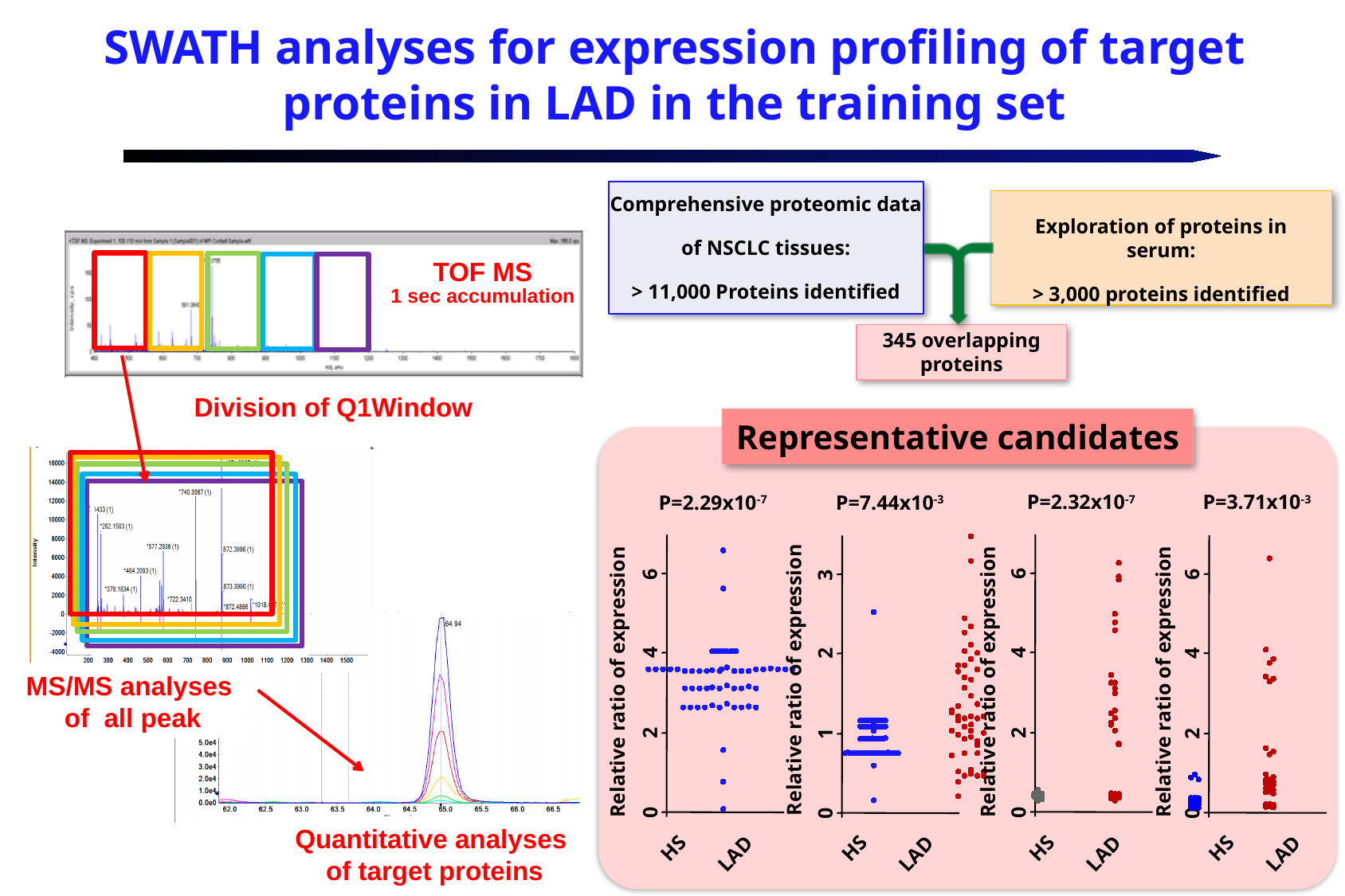
What is the highest y-axis tick value on the second 'Representative candidates' plot from the left? 3 What P value is printed above the rightmost 'Representative candidates' plot? P=3.71x10-3 What is the y-axis label of the 'Representative candidates' plots? Relative ratio of expression In the third 'Representative candidates' plot from the left, are the HS values greater or less than 2? less What is the highest y-axis tick value on the leftmost 'Representative candidates' plot? 6 How many dot plots are shown in the 'Representative candidates' panel? 4 In the third 'Representative candidates' plot from the left, which group has the higher maximum value, HS or LAD? LAD What P value is printed above the second 'Representative candidates' plot from the left? P=7.44x10-3 What kind of chart is used for each of the 'Representative candidates' plots? Dot (scatter) plot What P value is printed above the leftmost 'Representative candidates' plot? P=2.29x10-7 What are the two x-axis categories in each 'Representative candidates' plot? HS and LAD In the rightmost 'Representative candidates' plot, which group has the higher maximum value, HS or LAD? LAD